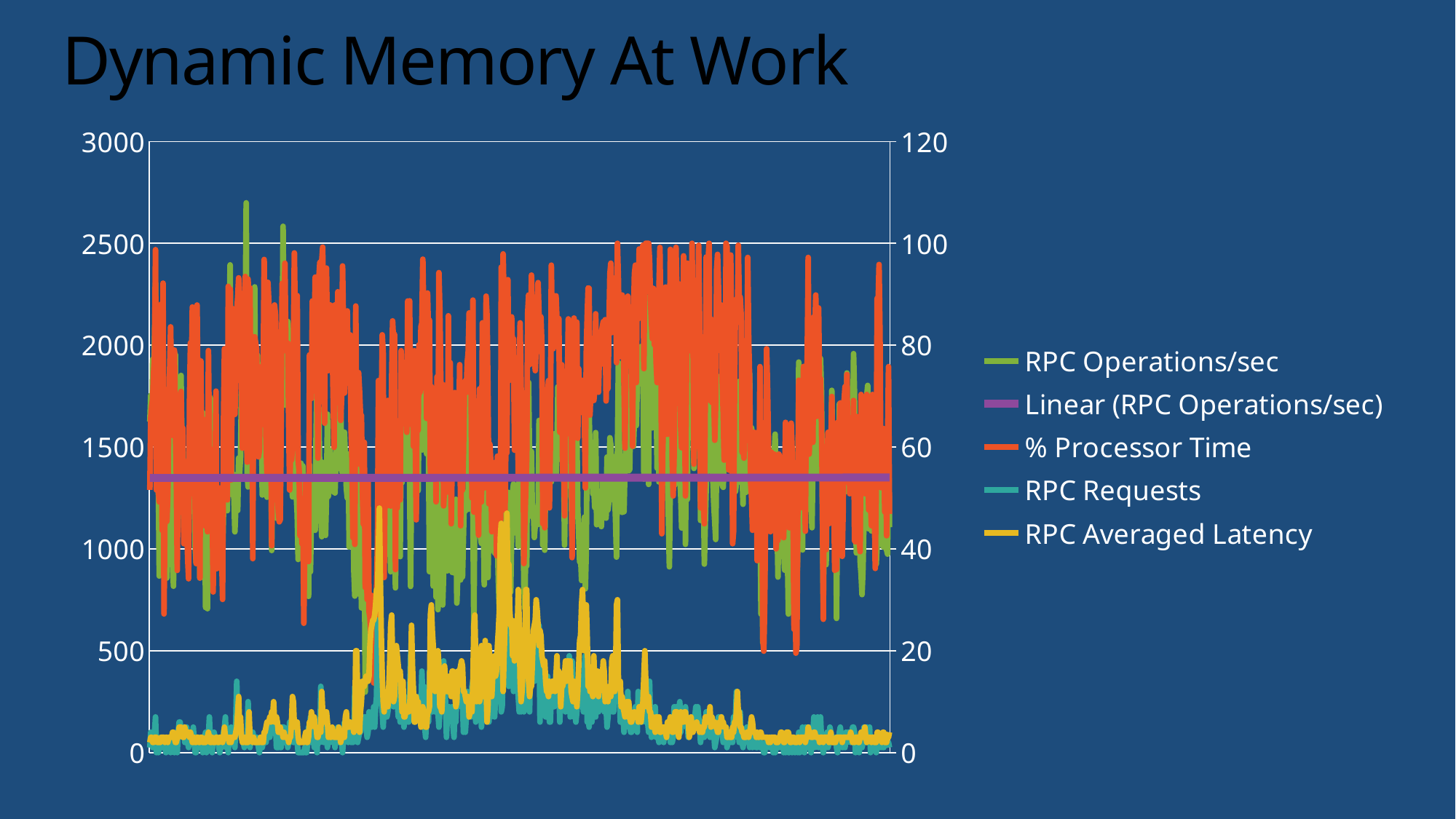
Which series reaches higher values on the chart, RPC Operations/sec or RPC Requests? RPC Operations/sec Is the Linear (RPC Operations/sec) trendline greater or less than 1500 on the left axis? less What is the highest value shown on the right-hand vertical axis? 120 Does the Linear (RPC Operations/sec) line rise, fall, or stay flat across the chart? stays flat Is the Linear (RPC Operations/sec) trendline greater or less than 1000 on the left axis? greater Which series is plotted as a straight horizontal line across the chart? Linear (RPC Operations/sec) What is the title of the slide containing the chart? Dynamic Memory At Work How many series does the legend list? 5 What kind of chart is shown on the slide? line chart Is the highest peak of RPC Operations/sec greater or less than 2500 on the left axis? greater